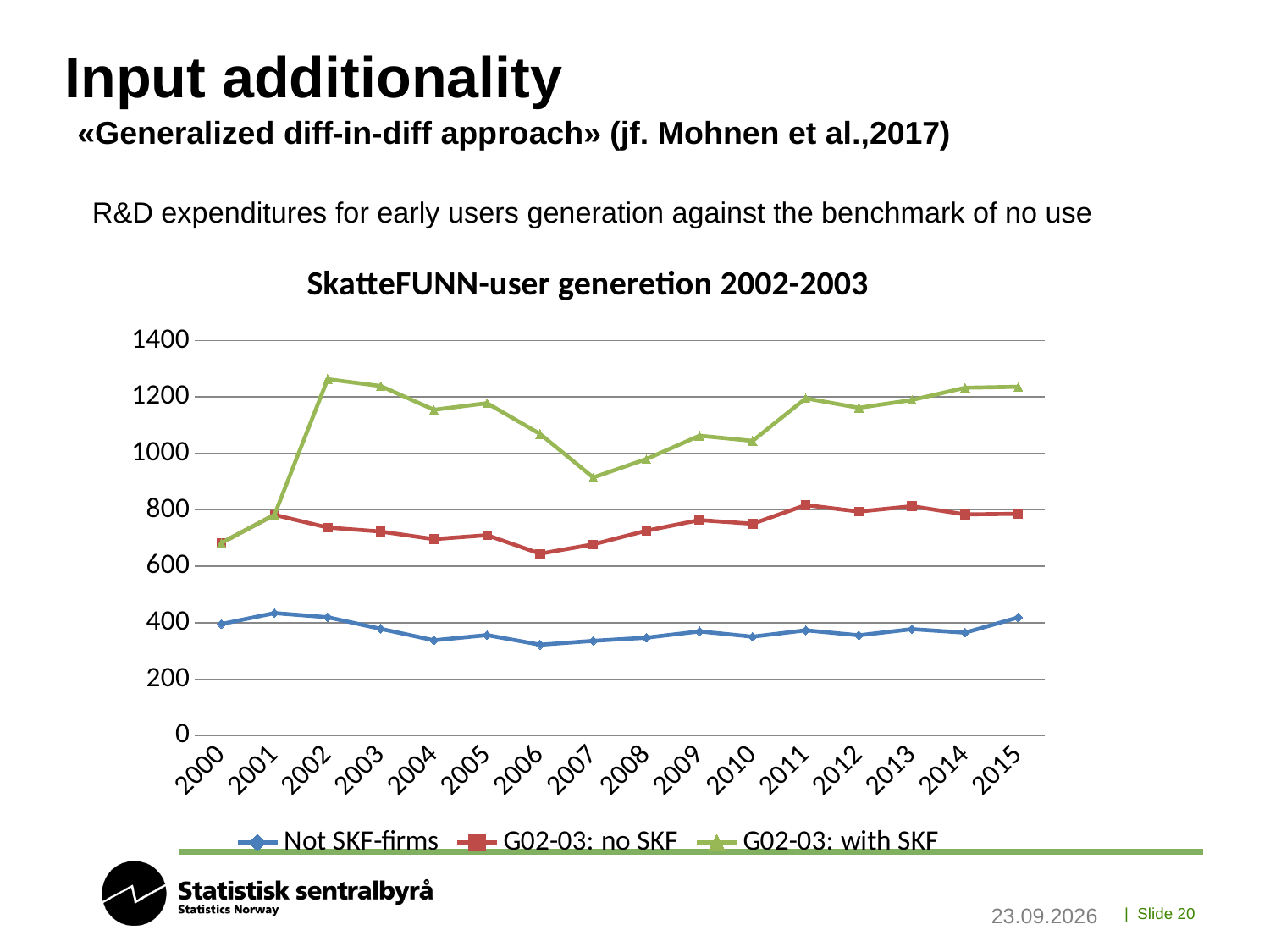
Which series has the highest value in 2015? G02-03: with SKF What kind of chart is shown on the slide? line chart Does the G02-03: with SKF series rise or fall from 2000 to 2002? rise Is the value for Not SKF-firms in 2006 greater or less than 400? less How many series does the legend list? 3 What is the title of the chart? SkatteFUNN-user generetion 2002-2003 How many years are plotted along the x axis? 16 Which series is shown with triangle markers in the legend? G02-03: with SKF Is the value for G02-03: with SKF in 2002 greater or less than 1200? greater Is the value for G02-03: no SKF in 2006 greater or less than 700? less In which year is the G02-03: no SKF series at its lowest? 2006